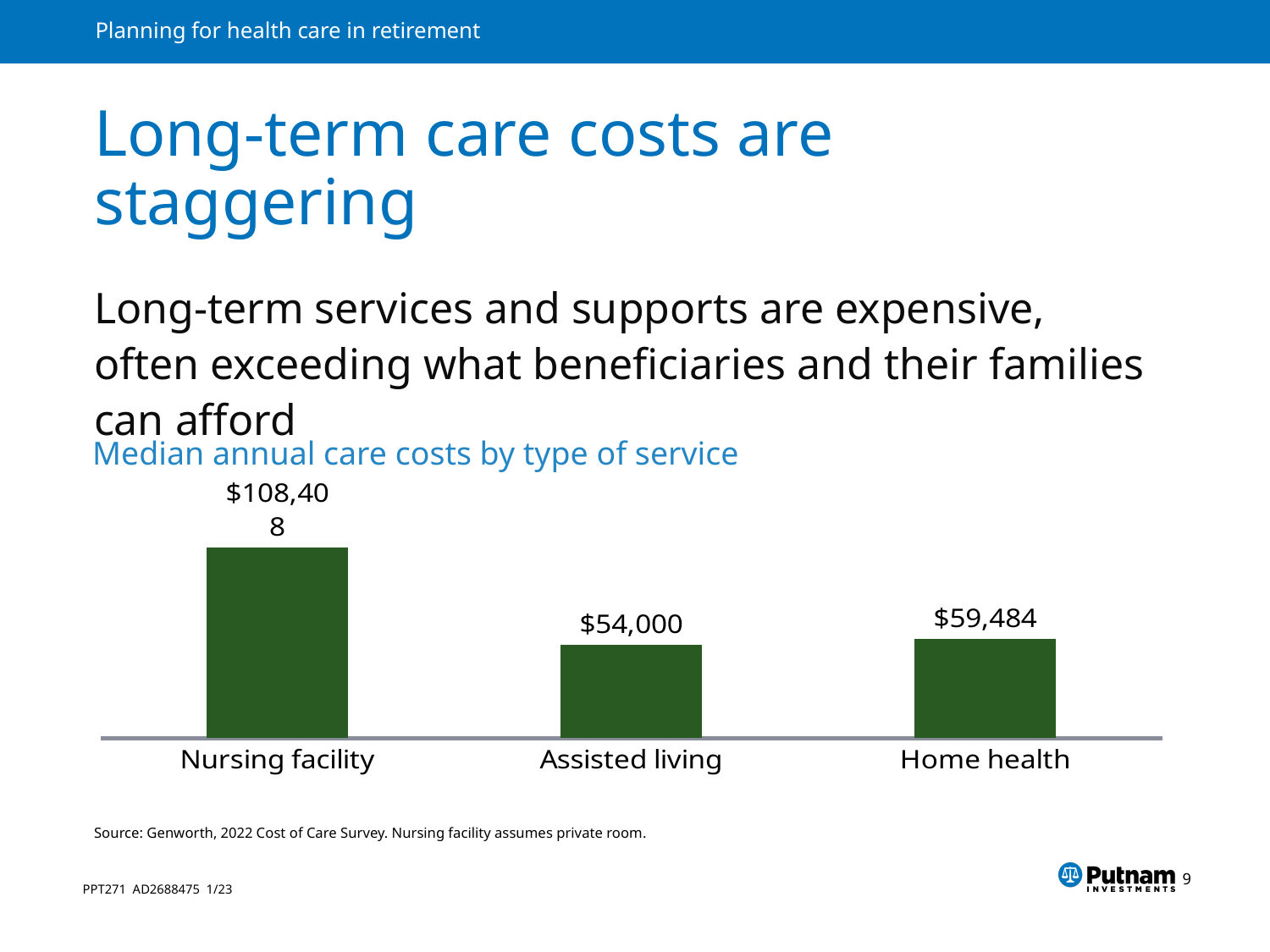
What kind of chart is shown on the slide? Bar chart Which type of service has the lowest median annual care cost? Assisted living What is the difference between the nursing facility cost and the assisted living cost? $54,408 Which type of service has the highest median annual care cost? Nursing facility What is the median annual care cost for home health? $59,484 Which is larger, the cost for home health or the cost for assisted living? Home health What is the difference between the home health cost and the assisted living cost? $5,484 What colour are the bars in the chart? Green How many types of service are shown in the chart? 3 What is the median annual care cost for a nursing facility? $108,408 What is the median annual care cost for assisted living? $54,000 What is the title of the chart? Median annual care costs by type of service